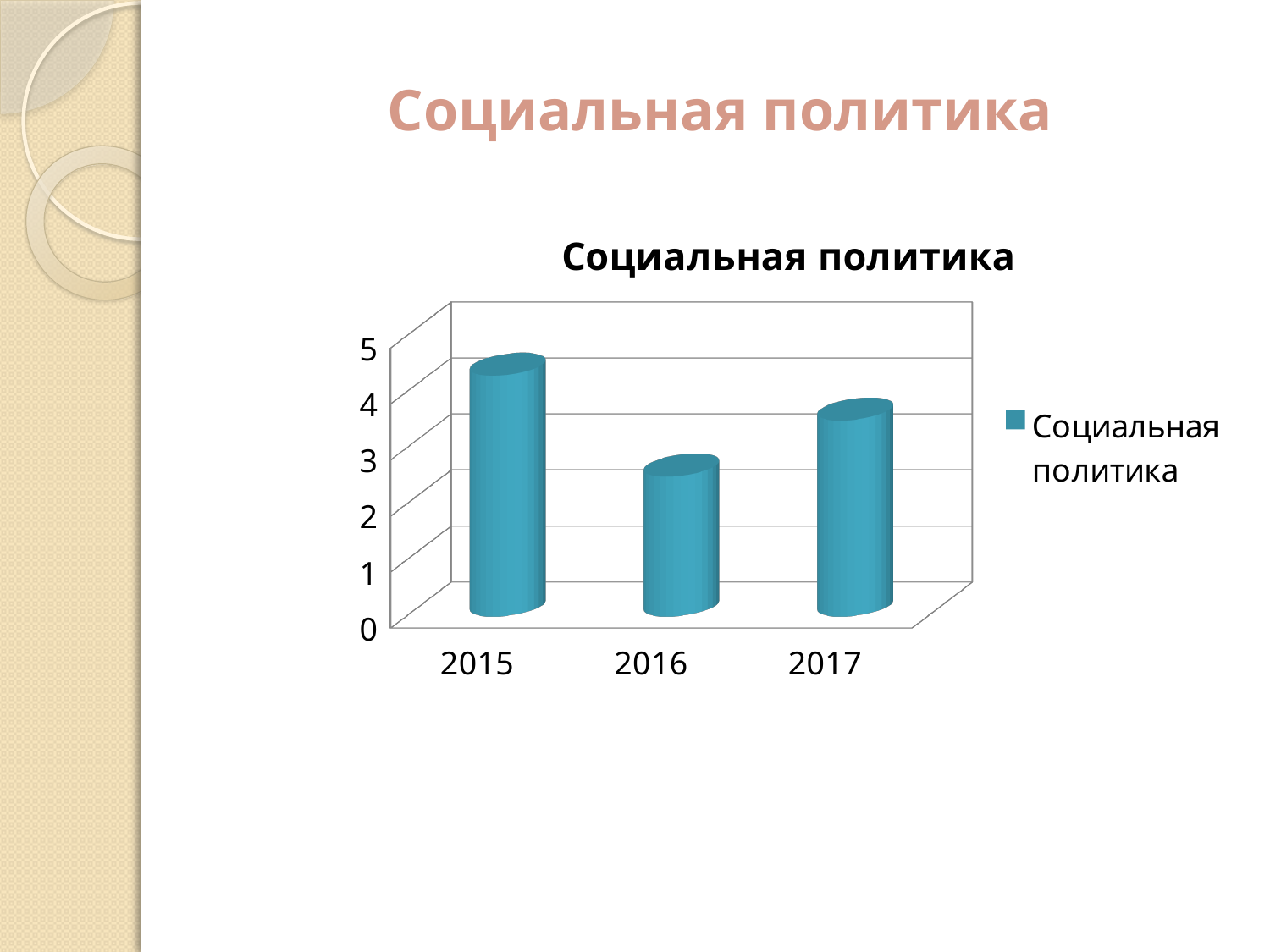
Which is larger, the value for 2015 or the value for 2017? 2015 Which year has the highest value in the chart? 2015 What is the title of the chart? Социальная политика How many series does the legend list? 1 What kind of chart is shown on the slide? bar chart Which year has the lowest value in the chart? 2016 Is the value for 2015 greater or less than 3? greater Does the value rise or fall from 2015 to 2016? fall Is the value for 2016 greater or less than 4? less How many years are shown on the x axis of the chart? 3 Which is larger, the value for 2016 or the value for 2017? 2017 Is the value for 2017 greater or less than 2? greater